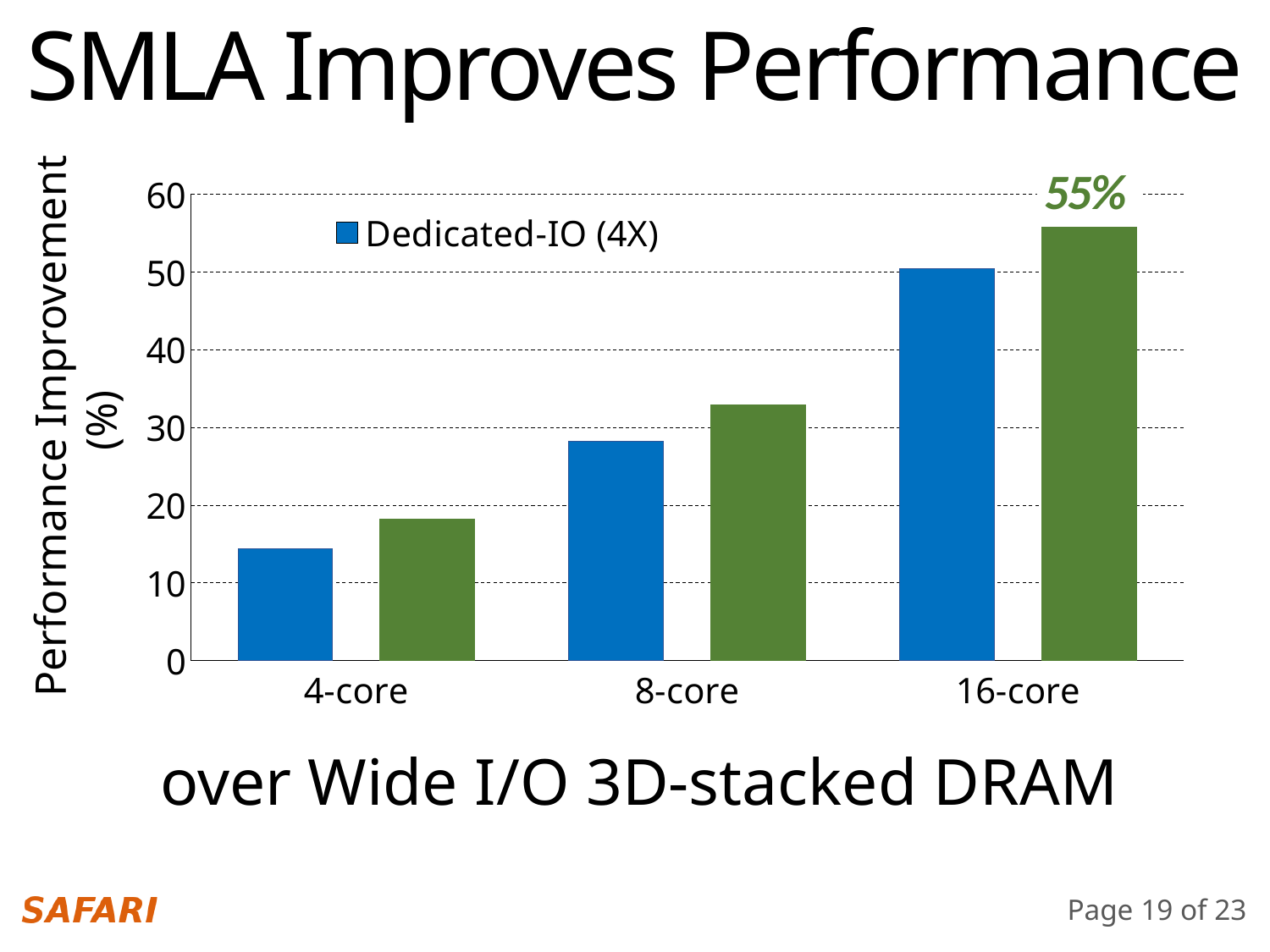
Do the Dedicated-IO (4X) values rise or fall from 4-core to 16-core? rise Is the Dedicated-IO (4X) value for 16-core greater or less than 40? greater Is the Dedicated-IO (4X) value for 4-core greater or less than 20? less How many series does the legend list? 1 Is the Dedicated-IO (4X) value for 8-core greater or less than 20? greater What is the title of the y axis? Performance Improvement (%) Which category has the highest Dedicated-IO (4X) value? 16-core Which category has the lowest Dedicated-IO (4X) value? 4-core What kind of chart is shown on the slide? bar chart How many core-count categories are shown on the x axis? 3 At 16-core, which bar is taller, the blue Dedicated-IO (4X) bar or the green bar? the green bar What value is labeled on the tallest green bar, for 16-core? 55%